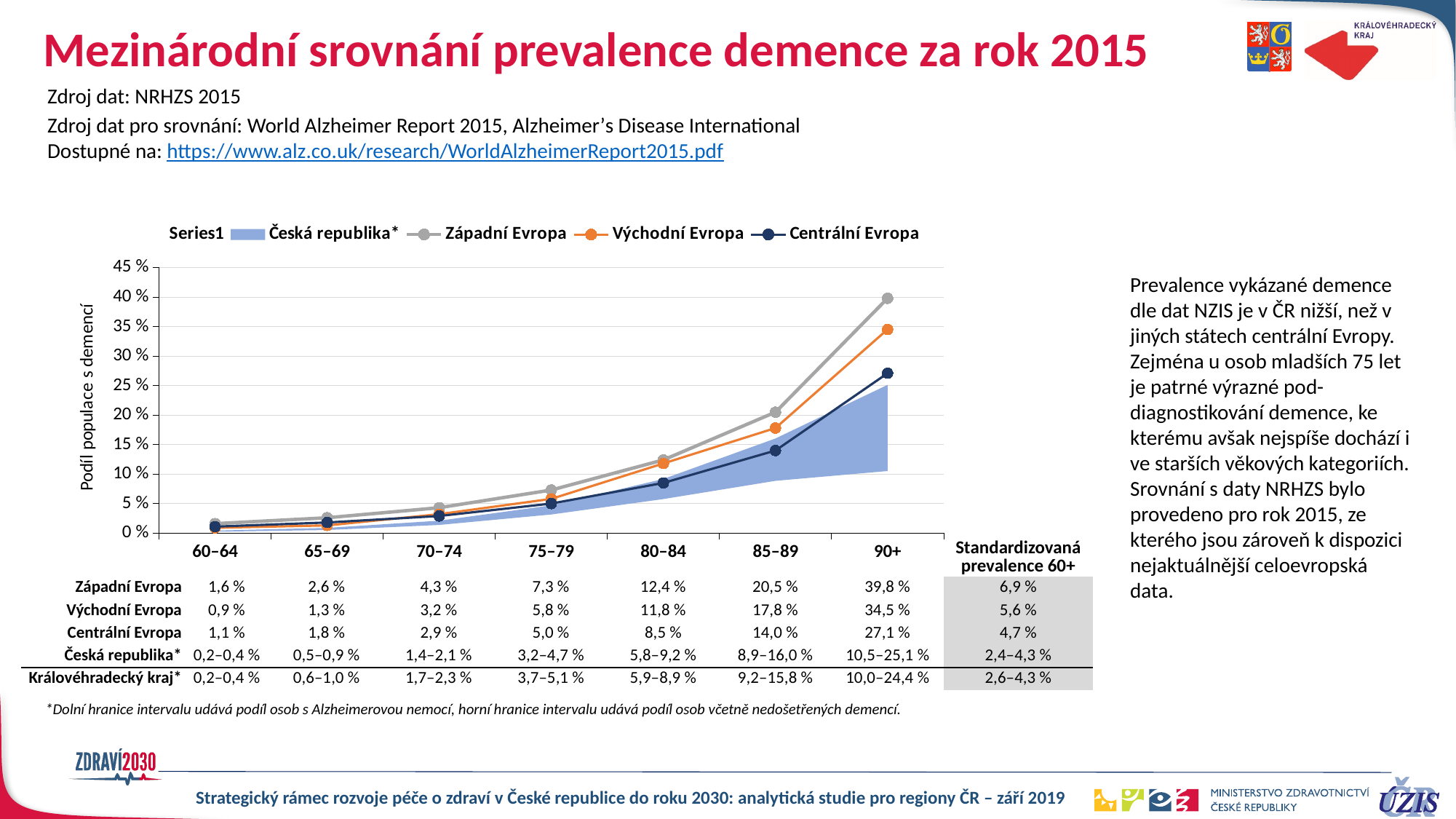
How many age groups are shown on the x axis? 7 Is the value for Centrální Evropa in the 90+ age group greater or less than 25 %? greater Do the values for Západní Evropa rise or fall across the age groups from 60–64 to 90+? rise What is the interval shown for Česká republika* in the 90+ age group? 10,5–25,1 % Which line series has the lowest value in the 60–64 age group? Východní Evropa Which is larger in the 75–79 age group, Východní Evropa or Centrální Evropa? Východní Evropa What is the value for Východní Evropa in the 85–89 age group? 17,8 % What is the value for Centrální Evropa in the 80–84 age group? 8,5 % What is the difference between Západní Evropa and Východní Evropa in the 90+ age group? 5,3 % Which line series has the highest value in the 90+ age group? Západní Evropa What is the value for Západní Evropa in the 90+ age group? 39,8 % What is the difference between Západní Evropa and Centrální Evropa in the 85–89 age group? 6,5 %